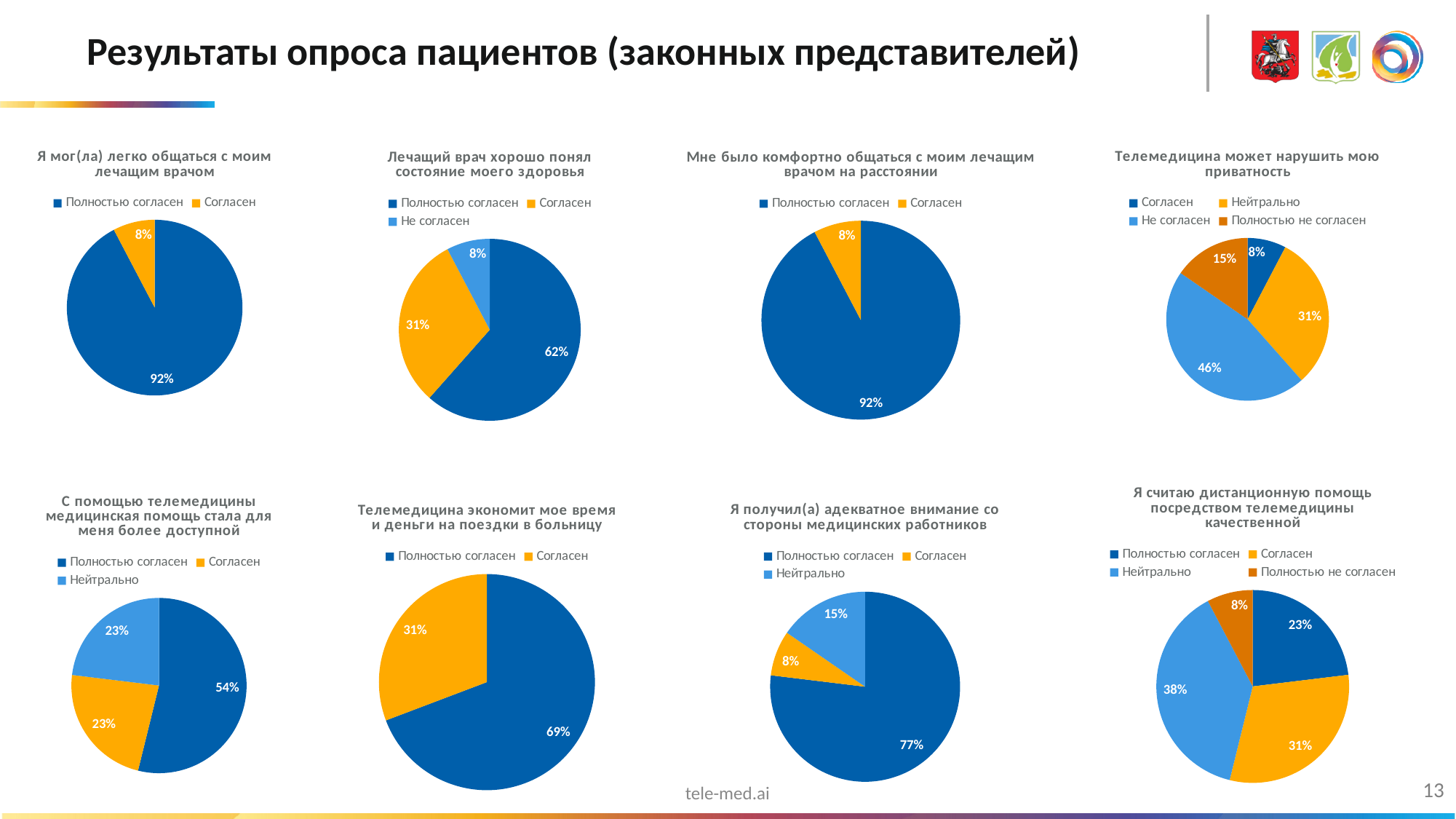
In the chart titled "Телемедицина может нарушить мою приватность", what percentage is shown for "Не согласен"? 46% In the chart titled "Лечащий врач хорошо понял состояние моего здоровья", what percentage is shown for "Не согласен"? 8% How many entries does the legend list for the chart titled "Телемедицина может нарушить мою приватность"? 4 In the chart titled "Я получил(а) адекватное внимание со стороны медицинских работников", which is larger: "Согласен" or "Нейтрально"? Нейтрально What type of chart is used for "Телемедицина экономит мое время и деньги на поездки в больницу"? Pie chart In the chart titled "С помощью телемедицины медицинская помощь стала для меня более доступной", what is the difference between the "Полностью согласен" and "Нейтрально" shares? 31% In the chart titled "Телемедицина экономит мое время и деньги на поездки в больницу", what percentage is shown for "Согласен"? 31% In the chart titled "Я считаю дистанционную помощь посредством телемедицины качественной", what percentage is shown for "Нейтрально"? 38% In the chart titled "Телемедицина может нарушить мою приватность", which response has the smallest slice? Согласен In the chart titled "Я мог(ла) легко общаться с моим лечащим врачом", what share of respondents answered "Полностью согласен"? 92% How many pie charts are shown on the slide? 8 In the chart titled "Лечащий врач хорошо понял состояние моего здоровья", which response has the largest slice? Полностью согласен